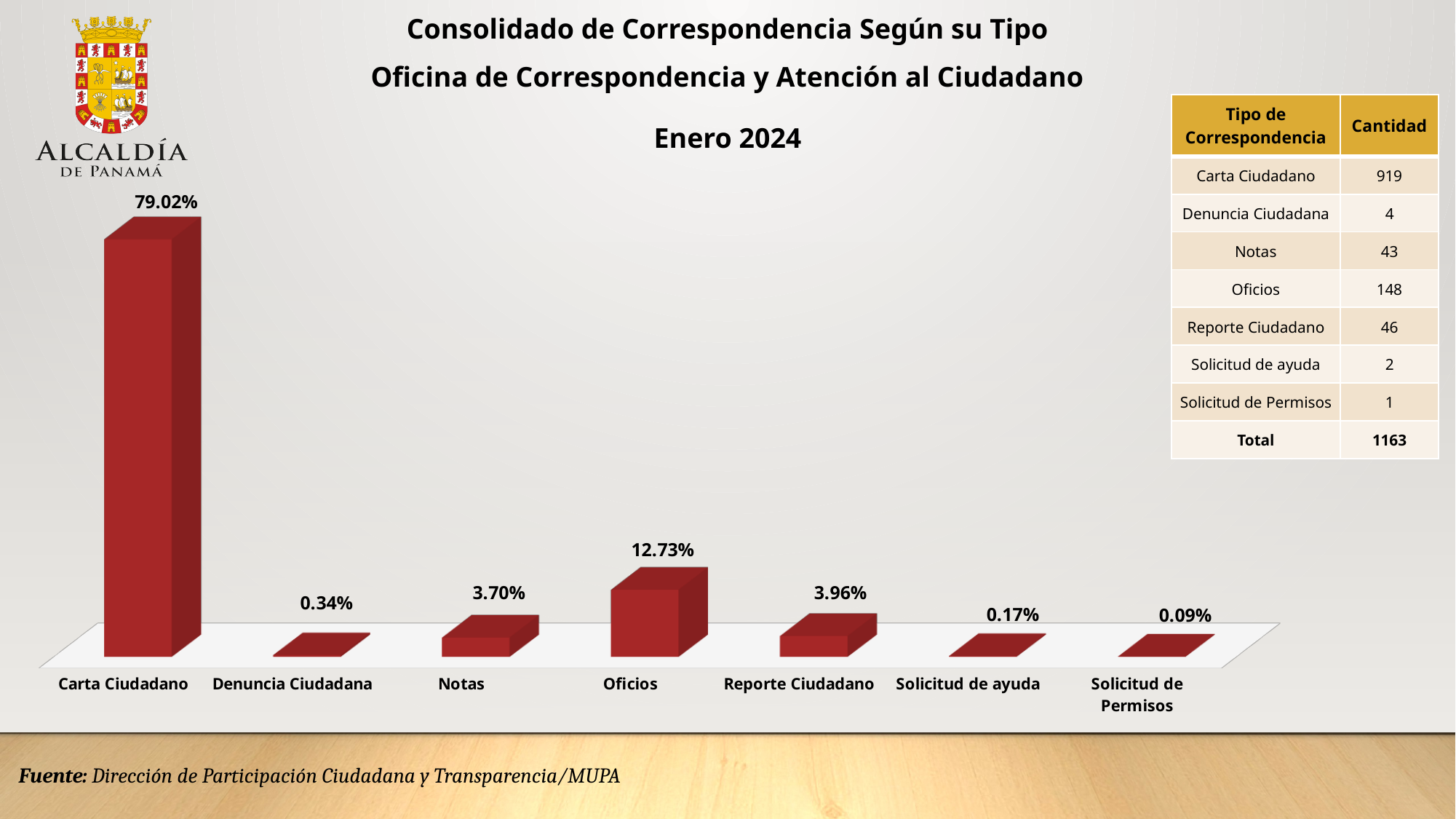
Which category has the lowest percentage? Solicitud de Permisos What is the difference in percentage points between Denuncia Ciudadana and Solicitud de ayuda? 0.17 What month and year does the chart title refer to? Enero 2024 What kind of chart is shown on the slide? Bar chart What percentage is shown for Oficios? 12.73% What percentage is shown for Carta Ciudadano? 79.02% What percentage is shown for Solicitud de Permisos? 0.09% How many categories are shown on the chart? 7 What percentage is shown for Reporte Ciudadano? 3.96% Which category has the highest percentage? Carta Ciudadano Which is larger, the percentage for Reporte Ciudadano or for Notas? Reporte Ciudadano What is the difference in percentage points between Oficios and Notas? 9.03